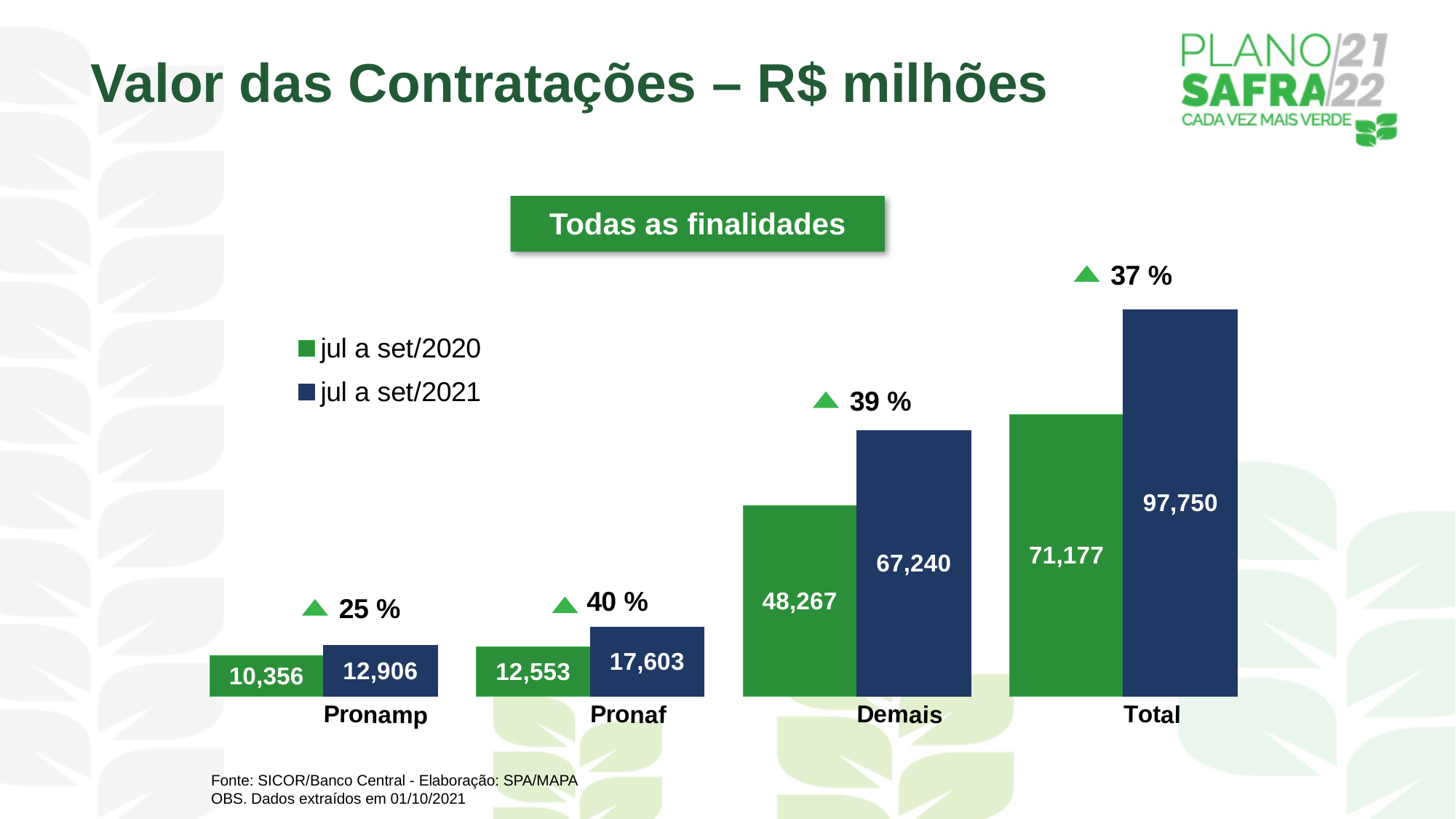
What is the value for Demais in the jul a set/2021 series? 67,240 What is the value for Pronamp in the jul a set/2020 series? 10,356 What percentage increase is shown above the Demais bars? 39 % Which is larger: the jul a set/2020 value for Demais or the jul a set/2021 value for Pronaf? jul a set/2020 value for Demais What is the value for Pronaf in the jul a set/2020 series? 12,553 Which category has the highest value in the jul a set/2021 series? Total How many series does the legend list? 2 What is the value for Total in the jul a set/2021 series? 97,750 What is the difference between the jul a set/2021 and jul a set/2020 values for Pronaf? 5,050 How many categories are shown on the x axis? 4 Which category has the lowest value in the jul a set/2020 series? Pronamp What is the difference between the jul a set/2021 and jul a set/2020 values for Total? 26,573